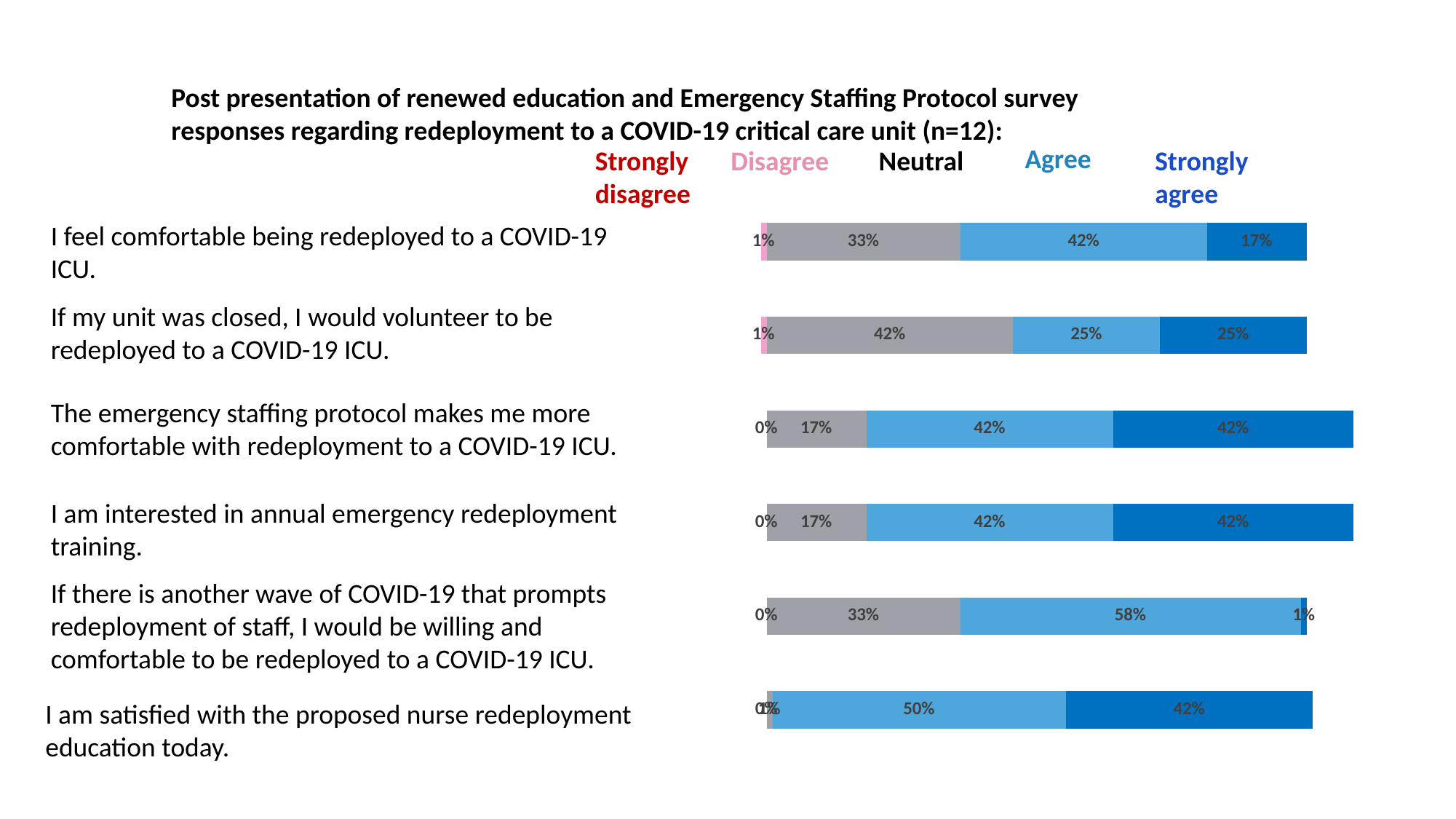
For "I feel comfortable being redeployed to a COVID-19 ICU", how many percentage points higher is Agree than Strongly agree? 25 For "If my unit was closed, I would volunteer to be redeployed to a COVID-19 ICU", how many percentage points higher is Neutral than Agree? 17 What percentage of respondents chose Agree for "If there is another wave of COVID-19 that prompts redeployment of staff, I would be willing and comfortable to be redeployed to a COVID-19 ICU"? 58% What percentage of respondents were Neutral on "If my unit was closed, I would volunteer to be redeployed to a COVID-19 ICU"? 42% What percentage of respondents were Neutral on "I feel comfortable being redeployed to a COVID-19 ICU"? 33% What kind of chart is shown on the slide? Stacked bar chart For "If my unit was closed, I would volunteer to be redeployed to a COVID-19 ICU", which response category has the largest share? Neutral How many response categories does the legend list? 5 What percentage of respondents chose Strongly agree for "I am satisfied with the proposed nurse redeployment education today"? 42% How many survey statements are shown in the chart? 6 For "I feel comfortable being redeployed to a COVID-19 ICU", which response category has the largest share? Agree Which statement has the larger Strongly agree share: "I feel comfortable being redeployed to a COVID-19 ICU" or "The emergency staffing protocol makes me more comfortable with redeployment to a COVID-19 ICU"? The emergency staffing protocol makes me more comfortable with redeployment to a COVID-19 ICU